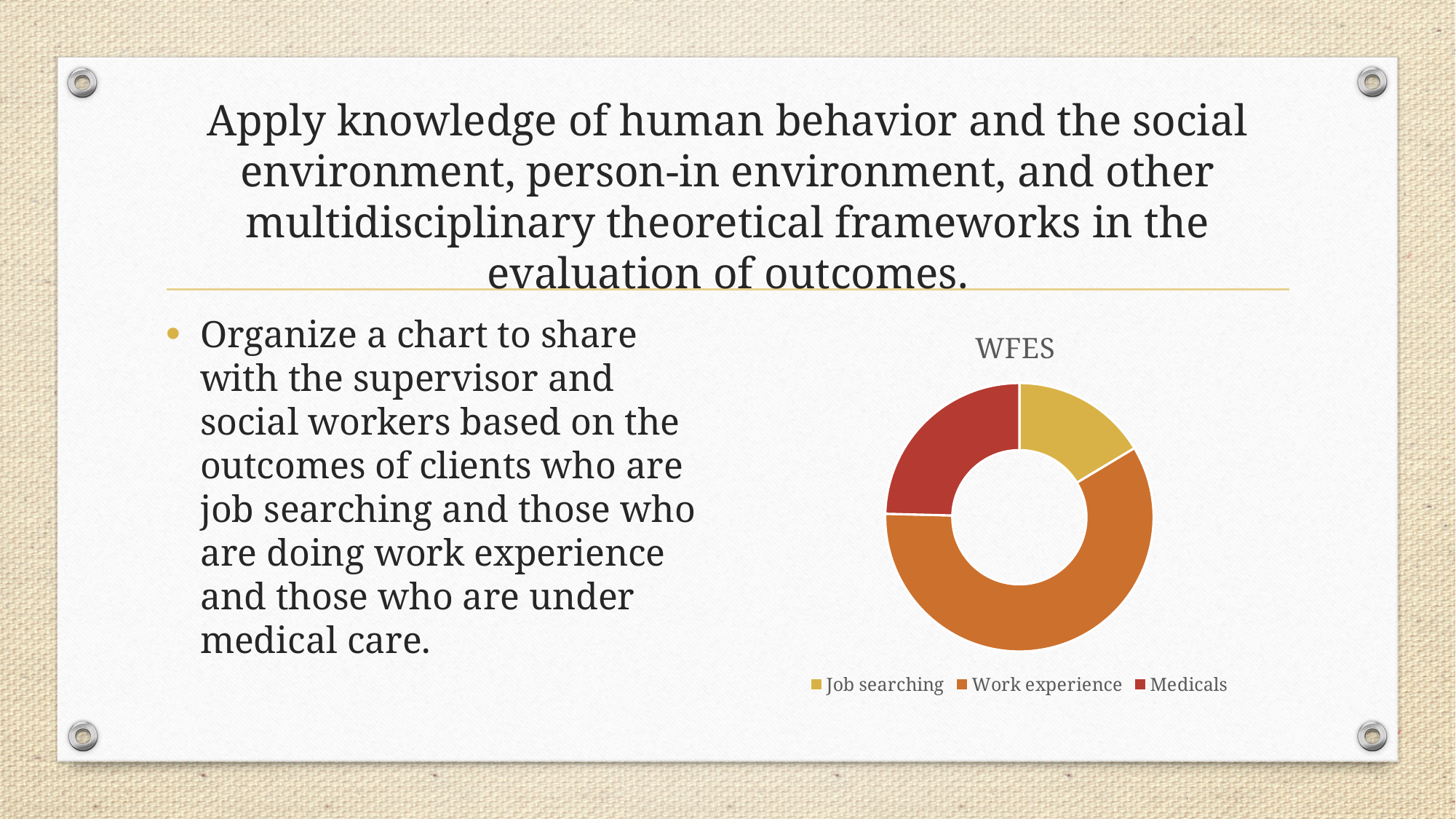
Which is larger, the share for Medicals or the share for Job searching? Medicals What kind of chart is shown on the slide? Doughnut chart Which category has the largest share of the chart? Work experience Which is larger, the share for Work experience or the share for Medicals? Work experience How many categories does the chart show? 3 Does Work experience account for more or less than half of the chart? more Which category has the smallest share of the chart? Job searching Which category is shown in red on the chart? Medicals What is the title of the chart? WFES